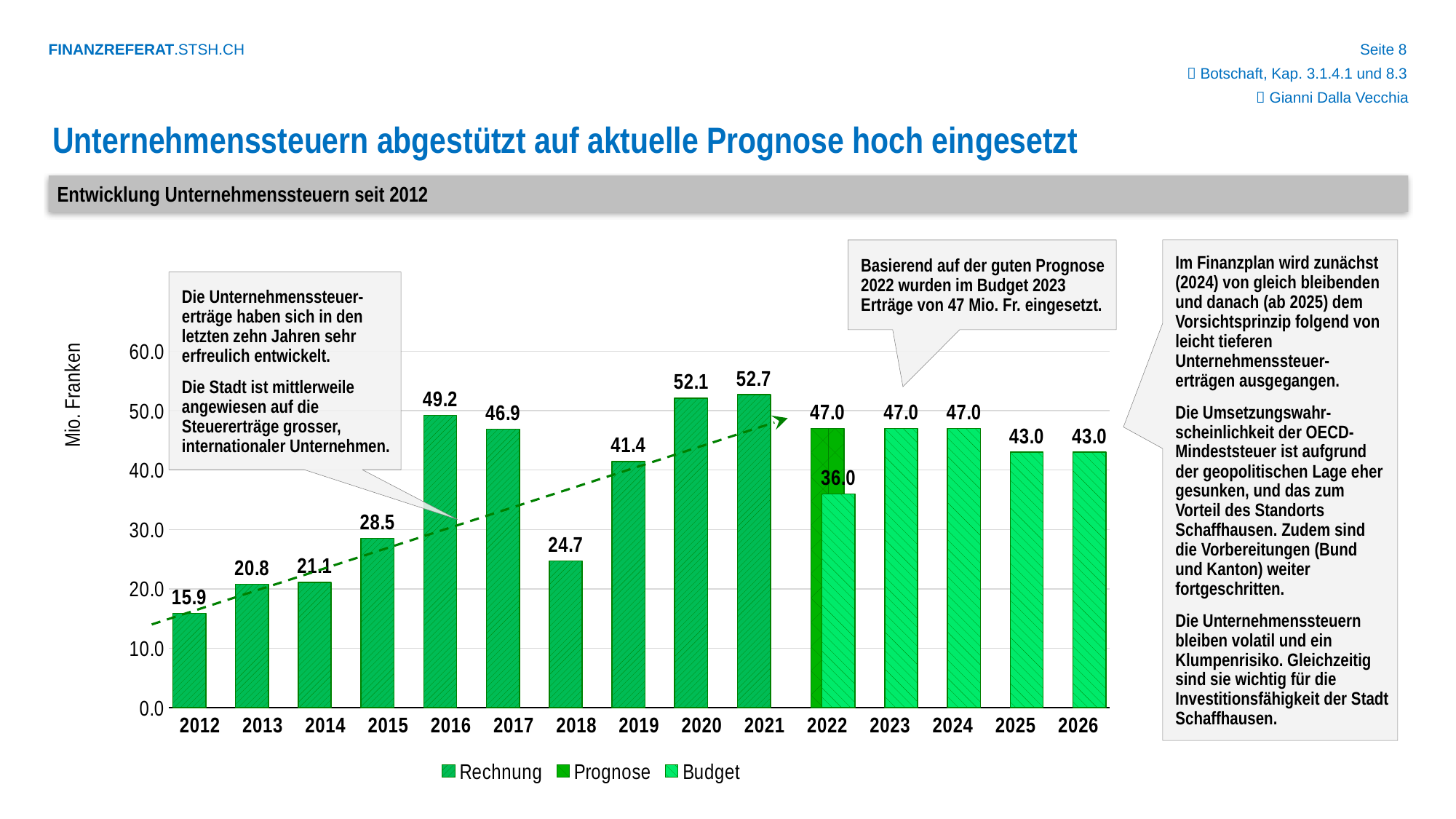
What kind of chart is shown on the slide? Bar chart Which is larger, the value for 2017 or the value for 2019? 2017 What is the Budget value for 2022? 36.0 What is the value for 2016 in the chart? 49.2 Which year has the highest value in the chart? 2021 How many years are shown on the x axis of the chart? 15 What is the difference between the values for 2021 and 2020? 0.6 What is the difference between the values for 2016 and 2018? 24.5 How many series does the legend list? 3 Which year has the lowest value in the chart? 2012 What is the label of the y axis of the chart? Mio. Franken What is the Prognose value for 2022? 47.0